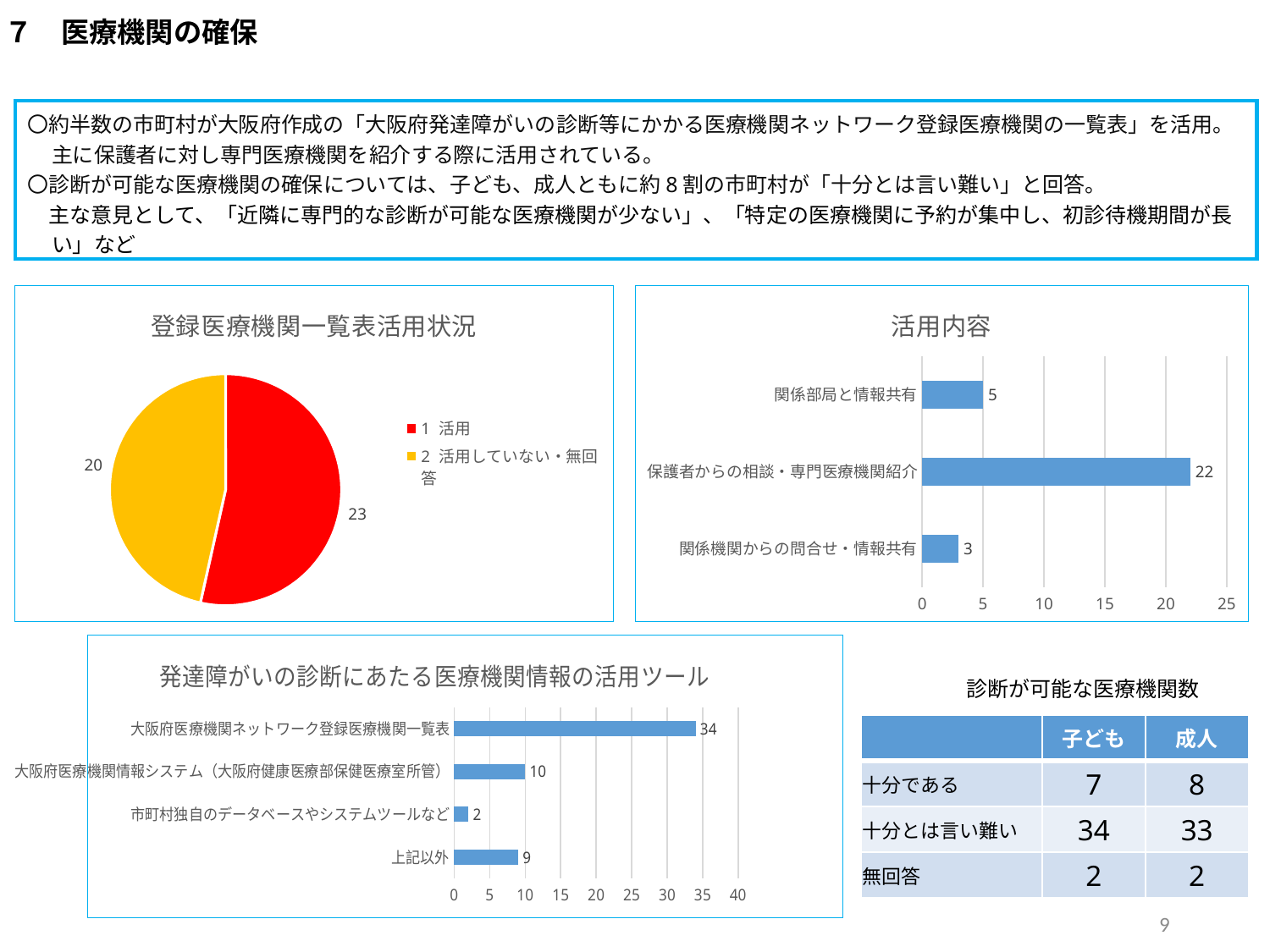
In the pie chart titled 登録医療機関一覧表活用状況, how many slices are there? 2 In the chart titled 発達障がいの診断にあたる医療機関情報の活用ツール, how many categories are shown? 4 What kind of chart is the chart titled 活用内容? Bar chart In the chart titled 発達障がいの診断にあたる医療機関情報の活用ツール, which category has the highest value? 大阪府医療機関ネットワーク登録医療機関一覧表 In the chart titled 活用内容, what is the difference between 保護者からの相談・専門医療機関紹介 and 関係部局と情報共有? 17 In the chart titled 活用内容, what is the value for 保護者からの相談・専門医療機関紹介? 22 In the pie chart titled 登録医療機関一覧表活用状況, what colour is the slice for 1 活用? Red In the pie chart titled 登録医療機関一覧表活用状況, what is the value for 2 活用していない・無回答? 20 In the pie chart titled 登録医療機関一覧表活用状況, what is the value for 1 活用? 23 In the chart titled 活用内容, which category has the lowest value? 関係機関からの問合せ・情報共有 In the chart titled 発達障がいの診断にあたる医療機関情報の活用ツール, what is the value for 大阪府医療機関ネットワーク登録医療機関一覧表? 34 In the chart titled 発達障がいの診断にあたる医療機関情報の活用ツール, which is larger: 大阪府医療機関情報システム（大阪府健康医療部保健医療室所管） or 上記以外? 大阪府医療機関情報システム（大阪府健康医療部保健医療室所管）